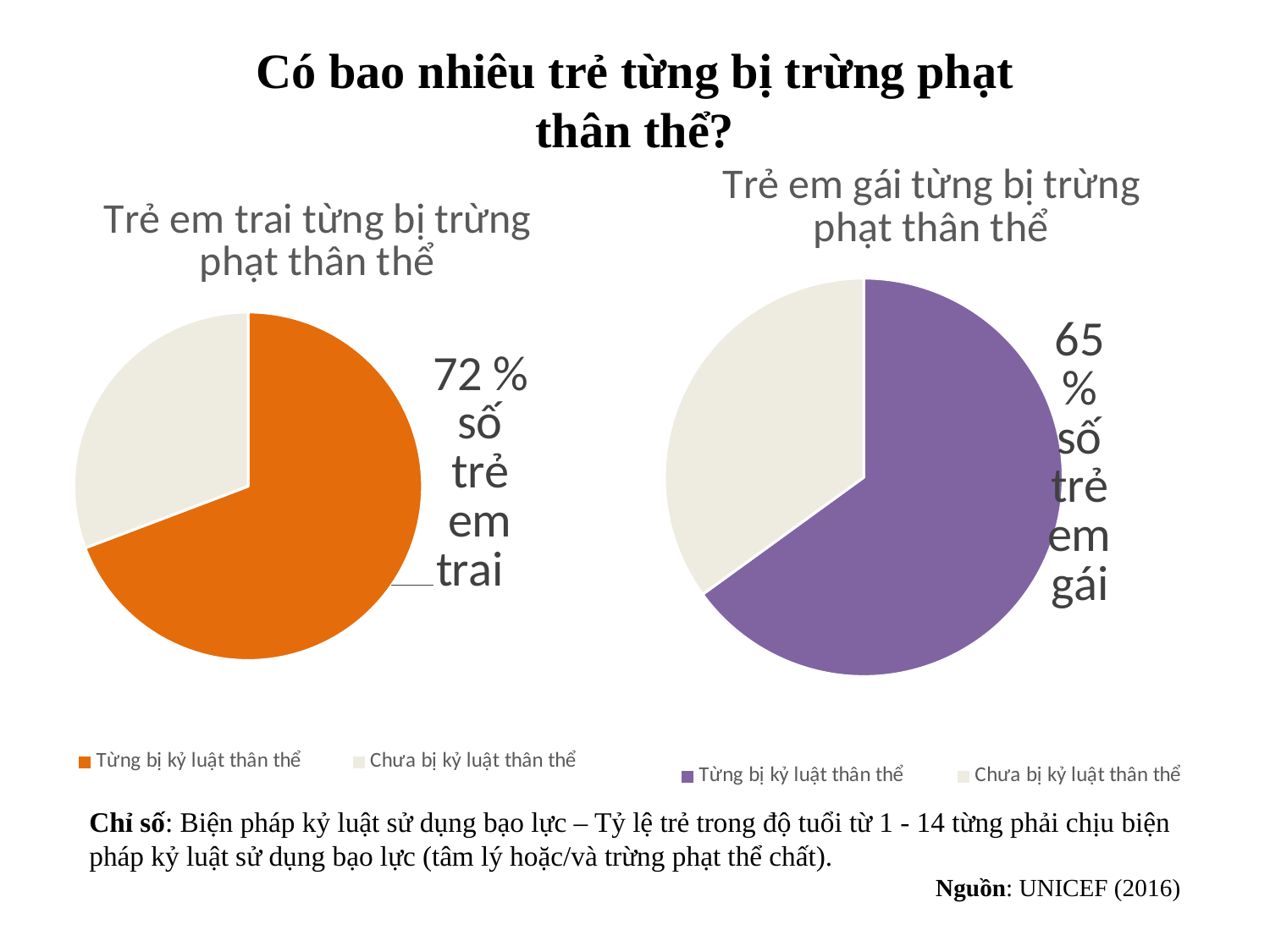
What kind of chart is the left chart, "Trẻ em trai từng bị trừng phạt thân thể"? Pie chart In the left chart (Trẻ em trai), which slice is the largest? Từng bị kỷ luật thân thể In the right chart (Trẻ em gái), what percentage is shown for the slice "Từng bị kỷ luật thân thể"? 65 % How many slices does the left chart (Trẻ em trai) have? 2 What is the difference between the "Từng bị kỷ luật thân thể" share in the left chart (Trẻ em trai) and in the right chart (Trẻ em gái)? 7 % In the right chart (Trẻ em gái), what colour is the slice "Từng bị kỷ luật thân thể"? Purple Which chart shows a larger share for "Từng bị kỷ luật thân thể": the left chart (Trẻ em trai) or the right chart (Trẻ em gái)? The left chart (Trẻ em trai) In the right chart (Trẻ em gái), which slice is the smallest? Chưa bị kỷ luật thân thể In the right chart (Trẻ em gái), is the share for "Từng bị kỷ luật thân thể" greater or less than 50%? greater In the left chart (Trẻ em trai), what percentage is shown for the slice "Từng bị kỷ luật thân thể"? 72 % What is the title of the left chart? Trẻ em trai từng bị trừng phạt thân thể How many entries does the legend of the right chart (Trẻ em gái) list? 2